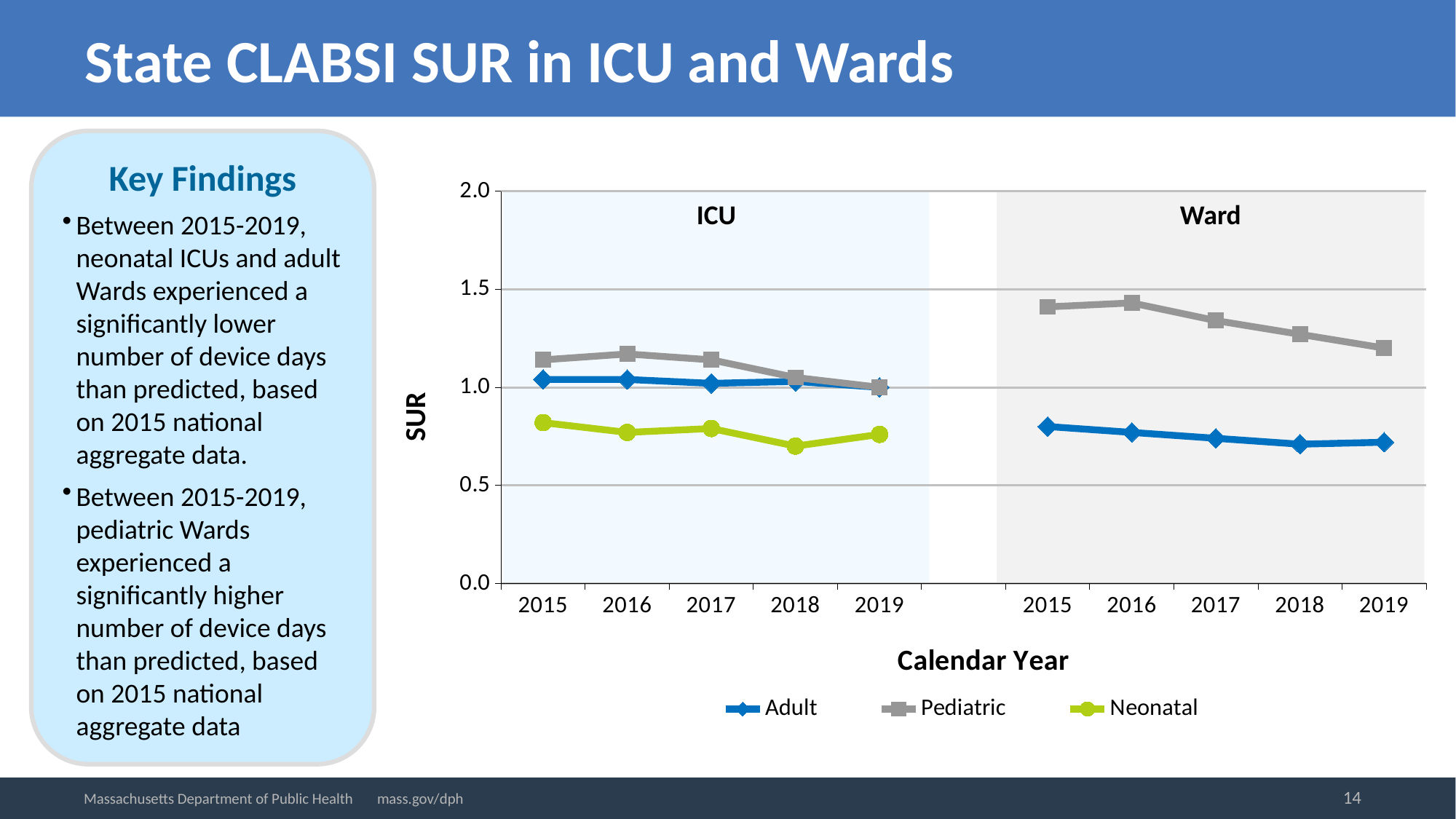
In the Ward panel, which series has the larger value in 2017, Adult or Pediatric? Pediatric In the Ward panel, does the Pediatric series rise or fall from 2016 to 2019? Fall How many calendar years are plotted in the ICU panel? 5 What is the label of the y axis? SUR In the ICU panel, is the Neonatal value for 2018 greater or less than 0.5? greater In the Ward panel, is the Pediatric value for 2015 greater or less than 1.0? greater In the ICU panel, which series has the larger value in 2015, Pediatric or Neonatal? Pediatric How many series does the legend list? 3 Which series appear in the Ward panel of the chart? Adult and Pediatric In the Ward panel, is the Adult value for 2019 greater or less than 1.0? less What kind of chart is shown on the slide? Line chart In the ICU panel, which year has the lowest Neonatal value? 2018